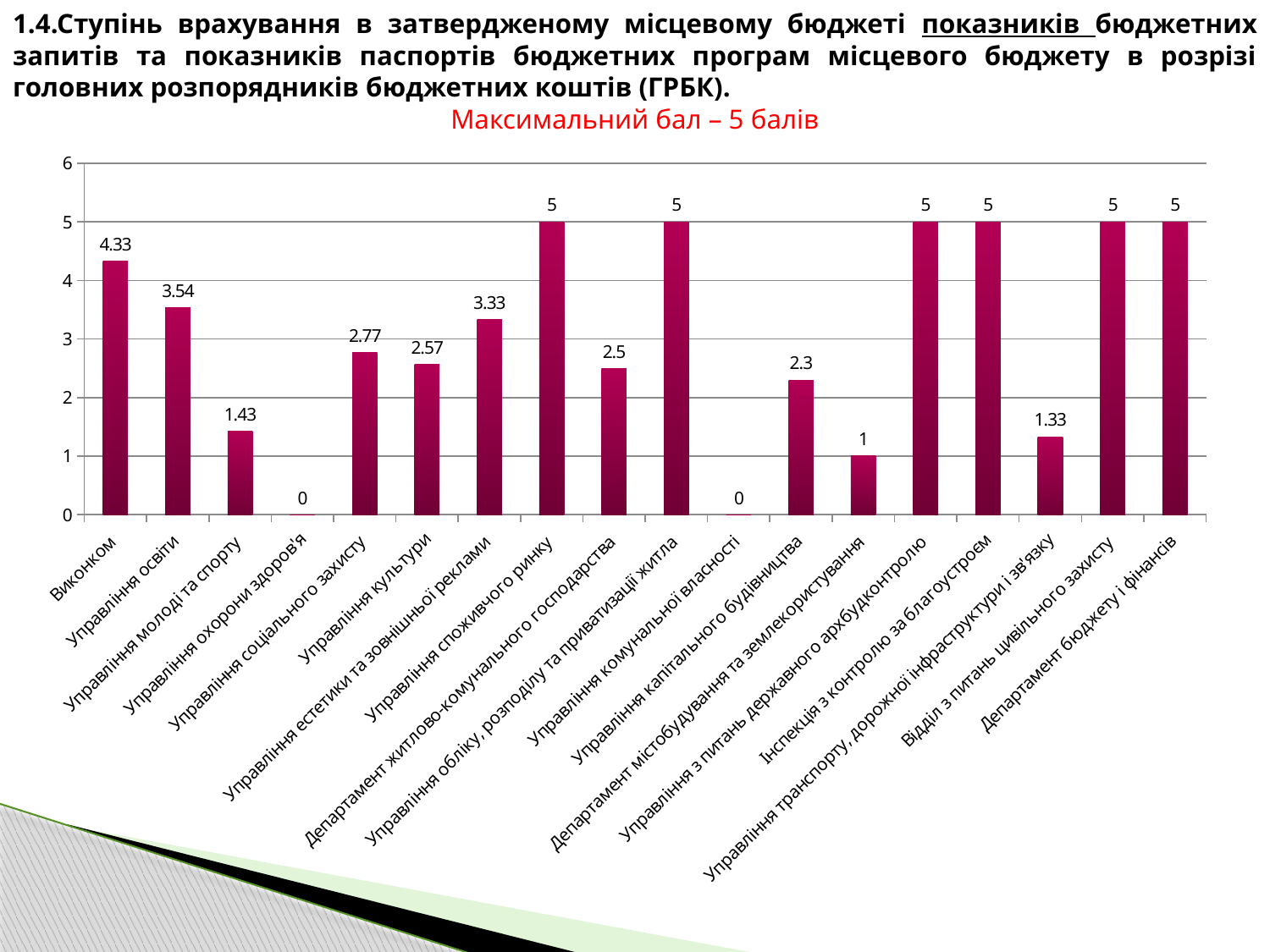
What is the maximum score stated in the subtitle of the chart? 5 балів How many categories are shown on the x axis? 18 What is the value for Управління освіти? 3.54 What is the value for Управління охорони здоров'я? 0 How many categories have a value of 5? 6 What is the value for Виконком? 4.33 What type of chart is shown on the slide? bar chart What is the value for Управління капітального будівництва? 2.3 Which is larger, the value for Управління соціального захисту or the value for Управління культури? Управління соціального захисту What is the value for Управління молоді та спорту? 1.43 What is the difference between the values for Виконком and Управління освіти? 0.79 What is the value for Управління транспорту, дорожньої інфраструктури і зв'язку? 1.33